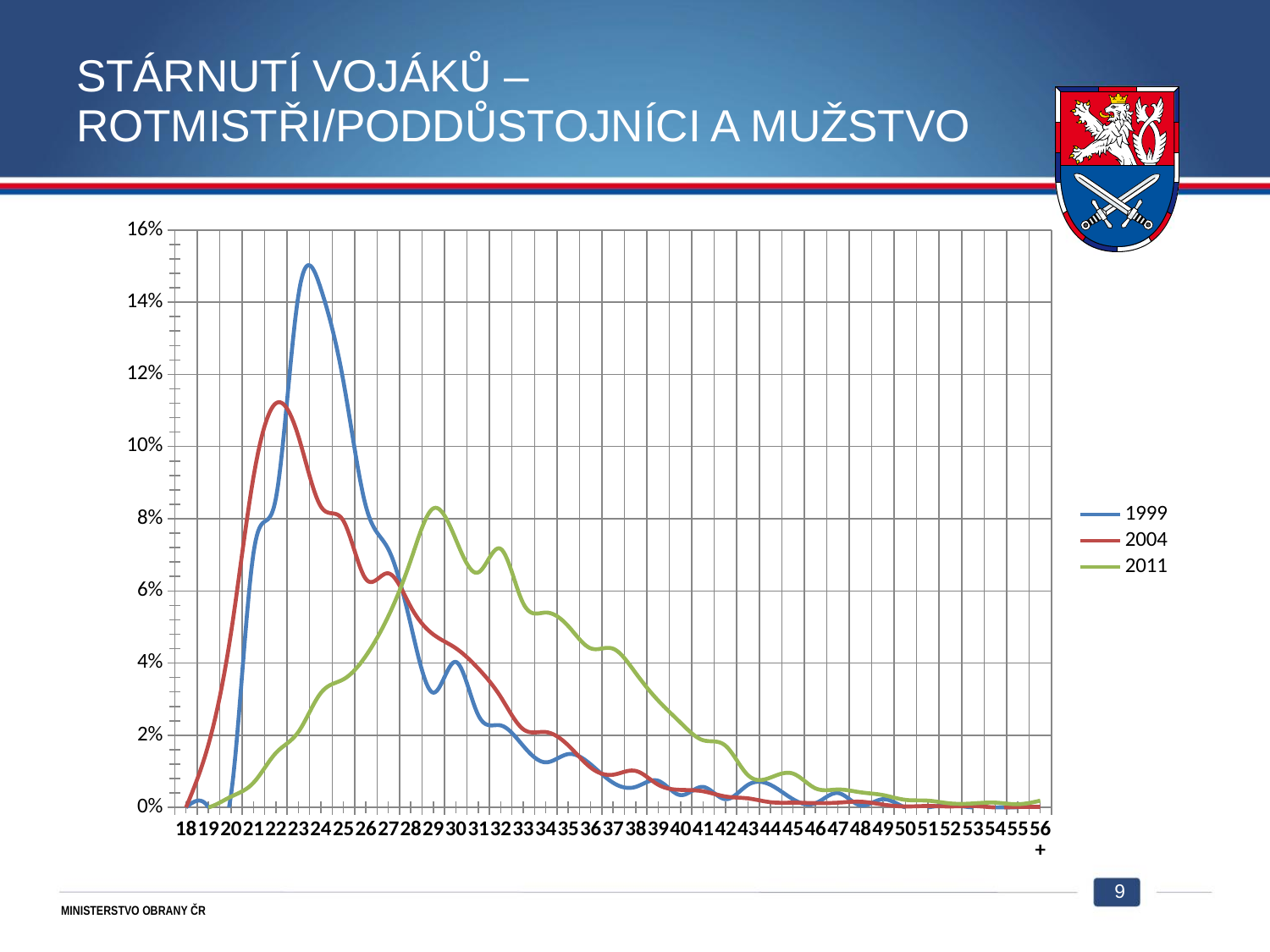
At age 35, which series has the larger value, 2011 or 1999? 2011 At which age does the 2011 series reach its highest value? 29 Is the value for the 2011 series at age 29 greater or less than 6%? greater How many series does the legend list? 3 Is the value for the 2004 series at age 22 greater or less than 10%? greater At which age does the 1999 series reach its highest value? 24 At age 23, which series has the larger value, 1999 or 2004? 1999 What kind of chart is shown on the slide? line chart Does the 2011 series rise or fall between age 18 and age 29? rise Which series reaches the highest peak value on the chart? 1999 Is the peak value of the 1999 series greater or less than 14%? greater Which years are listed in the chart legend? 1999, 2004, 2011